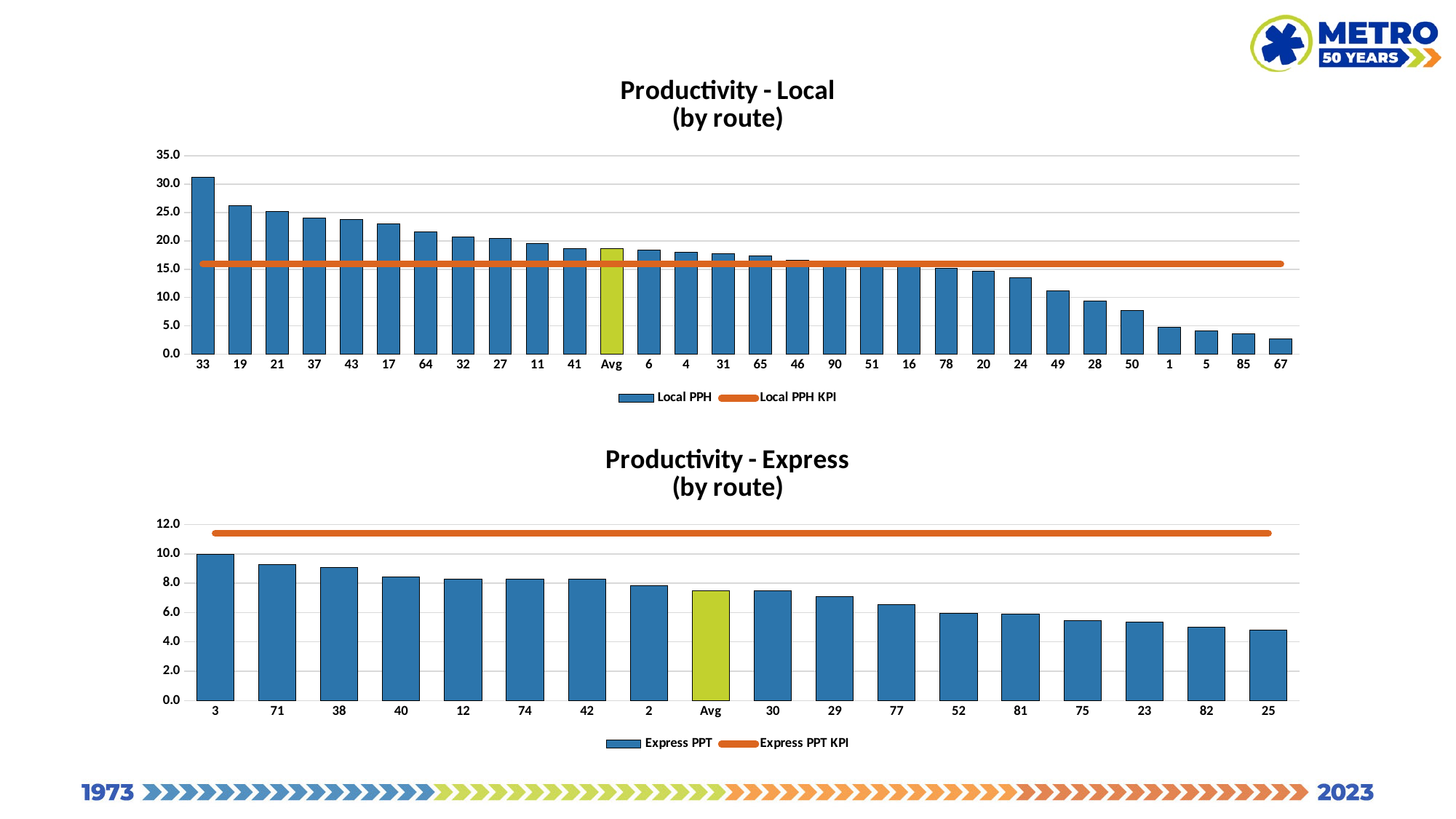
How many categories are shown on the x axis of the "Productivity - Local (by route)" chart? 30 In the "Productivity - Local (by route)" chart, is the Local PPH value for route 64 greater or less than 20.0? greater What kind of chart is the "Productivity - Local (by route)" chart? combination bar and line chart In the "Productivity - Express (by route)" chart, which route has the highest Express PPT? 3 In the "Productivity - Express (by route)" chart, which series is drawn as an orange line? Express PPT KPI In the "Productivity - Local (by route)" chart, which route has the lowest Local PPH? 67 In the "Productivity - Local (by route)" chart, is the Local PPH value for route 50 greater or less than 10.0? less In the "Productivity - Express (by route)" chart, which route has the lowest Express PPT? 25 How many series does the legend of the "Productivity - Local (by route)" chart list? 2 In the "Productivity - Express (by route)" chart, do the Express PPT bar values rise or fall from left to right along the x axis? fall In the "Productivity - Local (by route)" chart, which route has the highest Local PPH? 33 How many categories are shown on the x axis of the "Productivity - Express (by route)" chart? 18